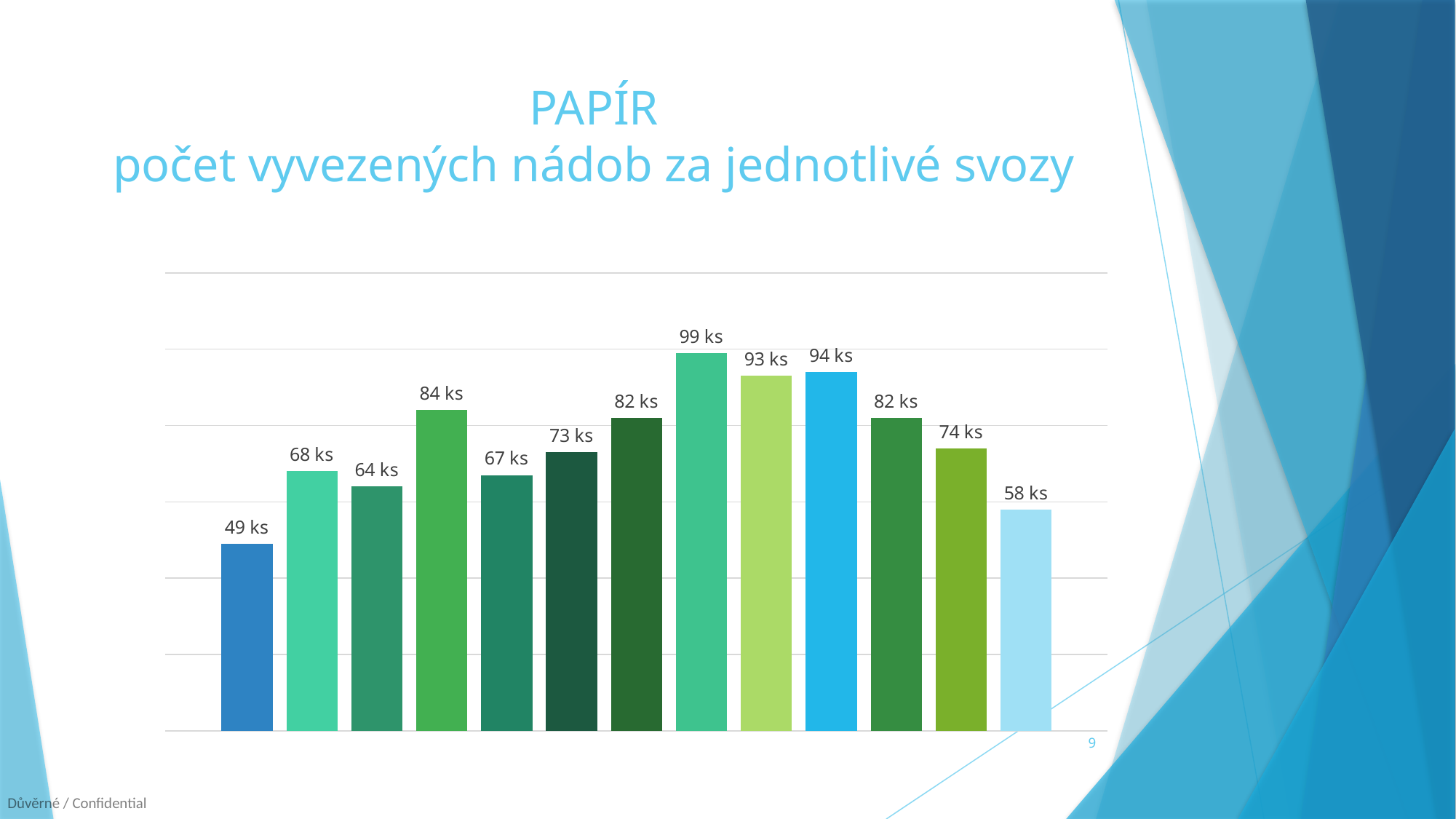
How many bars are plotted in the chart? 13 What is the difference between the highest bar (99 ks) and the lowest bar (49 ks)? 50 ks What is the highest value shown in the chart? 99 ks Which is larger, the second bar (68 ks) or the third bar (64 ks)? the second bar (68 ks) Do the values rise or fall from the eighth bar to the last bar? fall What is the value of the last (rightmost) bar? 58 ks What is the difference between the ninth bar (93 ks) and the tenth bar (94 ks)? 1 ks What is the title of the chart on the slide? PAPÍR počet vyvezených nádob za jednotlivé svozy What is the lowest value shown in the chart? 49 ks What is the value of the first (leftmost) bar? 49 ks What is the value of the fourth bar from the left? 84 ks What kind of chart is shown on the slide? bar chart